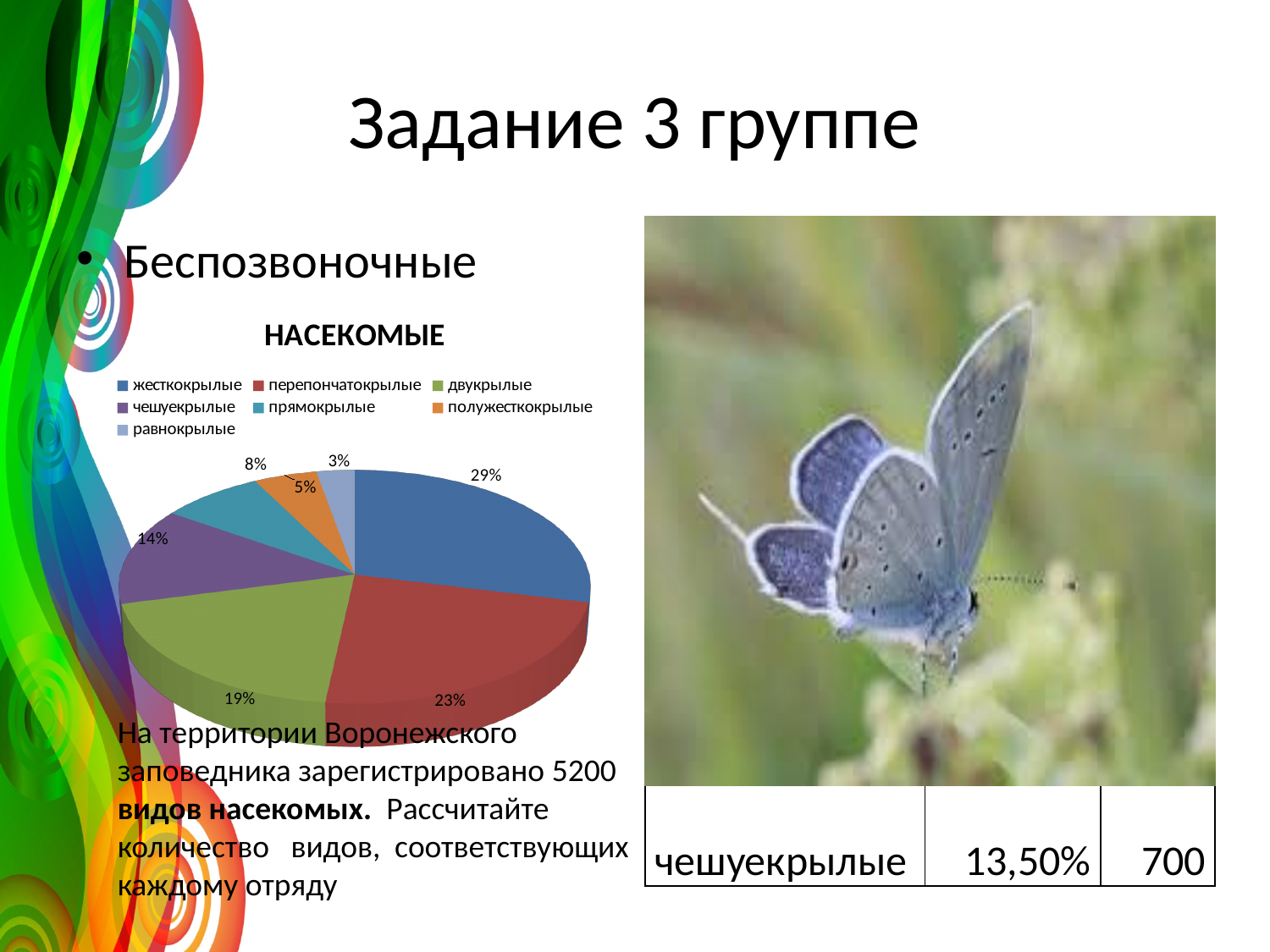
What kind of chart is shown on the slide? pie chart Which category has the smallest slice of the pie? равнокрылые Which is larger, the share for прямокрылые or the share for полужесткокрылые? прямокрылые What share of the pie does жесткокрылые have? 29% How many categories does the legend of the pie chart list? 7 What share of the pie does равнокрылые have? 3% What is the difference in percentage points between жесткокрылые and чешуекрылые? 15 What share of the pie does перепончатокрылые have? 23% What is the title of the chart? НАСЕКОМЫЕ Which category has the largest slice of the pie? жесткокрылые